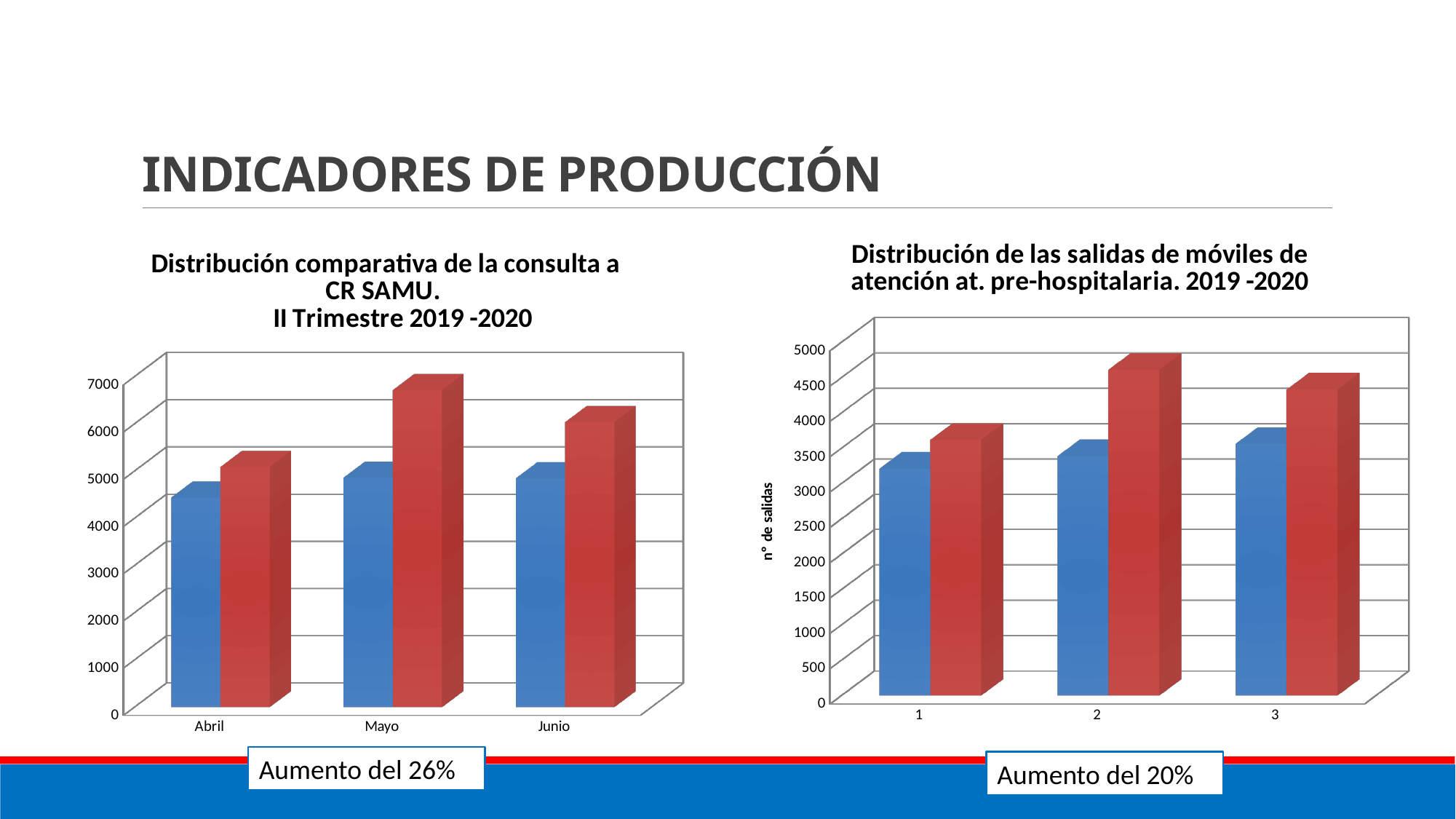
What type of chart is the left chart titled 'Distribución comparativa de la consulta a CR SAMU. II Trimestre 2019 -2020'? bar chart What is the label of the vertical axis on the right chart (Distribución de las salidas de móviles de atención at. pre-hospitalaria)? n° de salidas In the left chart (Distribución comparativa de la consulta a CR SAMU), in which month is the blue bar the lowest? Abril How many categories are shown on the x axis of the right chart (Distribución de las salidas de móviles de atención at. pre-hospitalaria)? 3 In the right chart (Distribución de las salidas de móviles de atención at. pre-hospitalaria), do the blue bars rise or fall from category 1 to category 3? rise In the right chart (Distribución de las salidas de móviles de atención at. pre-hospitalaria), is the red bar for category 2 greater or less than 4000? greater In the left chart (Distribución comparativa de la consulta a CR SAMU), in which month is the red bar the highest? Mayo In the left chart (Distribución comparativa de la consulta a CR SAMU), is the blue bar for Abril greater or less than 5000? less How many categories are shown on the x axis of the left chart (Distribución comparativa de la consulta a CR SAMU)? 3 In the left chart (Distribución comparativa de la consulta a CR SAMU), which red bar is larger, Abril or Mayo? Mayo In the right chart (Distribución de las salidas de móviles de atención at. pre-hospitalaria), at which category is the red bar the highest? 2 In the left chart (Distribución comparativa de la consulta a CR SAMU), is the red bar for Mayo greater or less than 6000? greater